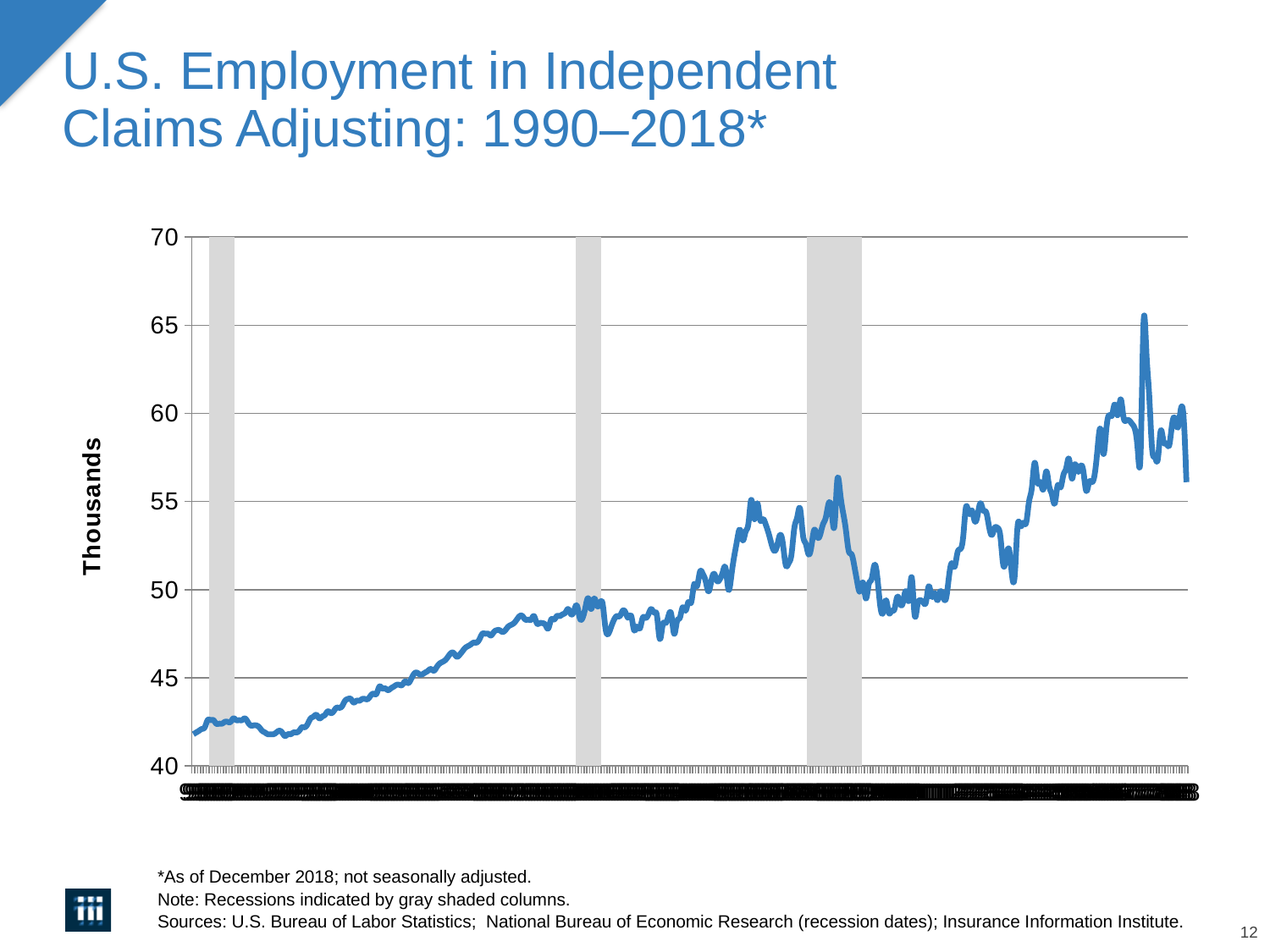
Is the highest value reached by the line greater or less than 60? greater Is the value at the end of the series greater or less than 50? greater What is the label on the vertical axis? Thousands Is the value at the start of the series greater or less than the value at the end of the series? less Overall, do the values rise or fall from the start of the series to the end? Rise Is the value at the start of the series greater or less than 45? less How many gray shaded columns (recessions) are shown on the chart? 3 What kind of chart is shown on the slide? Line chart